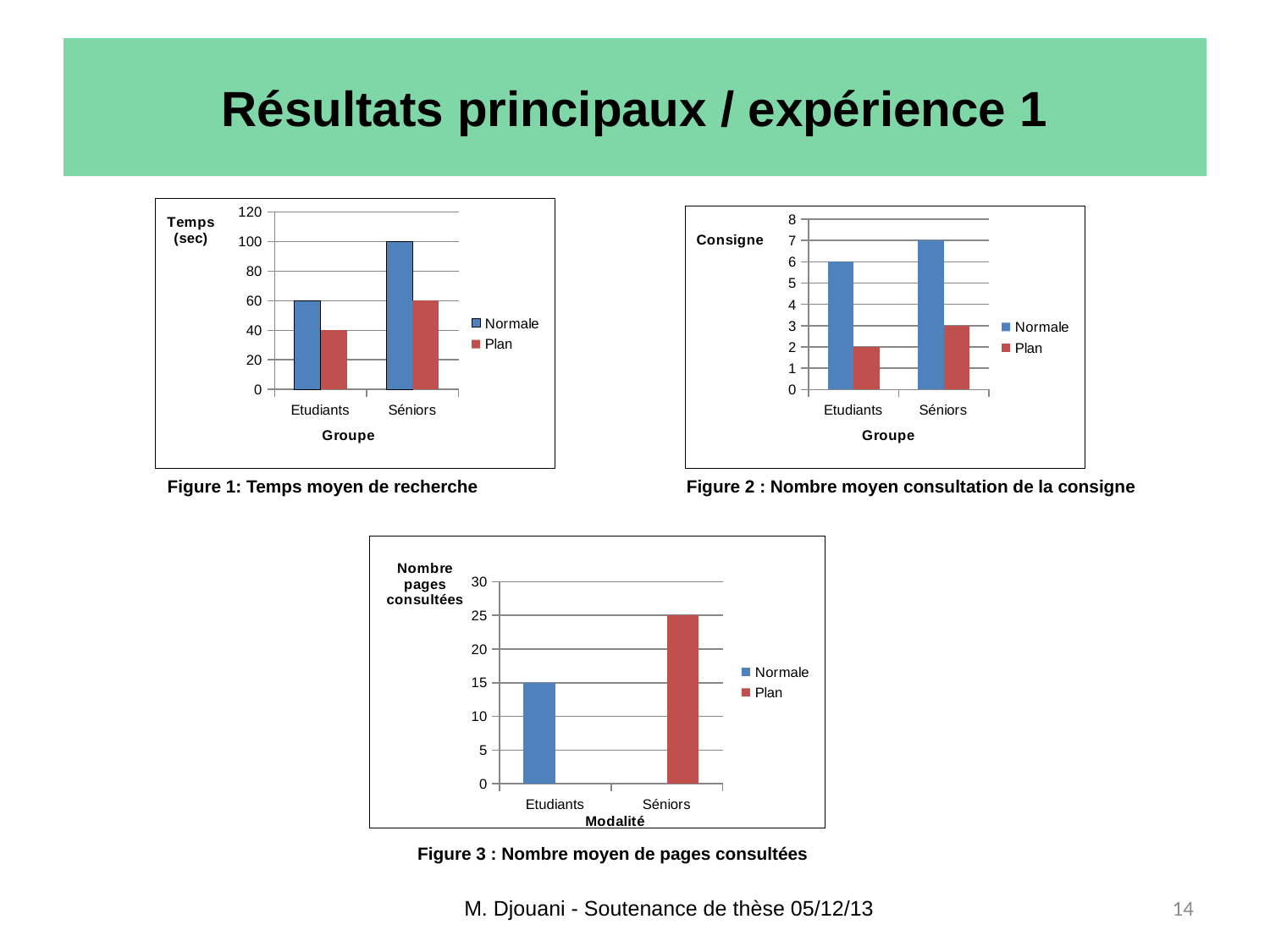
In Figure 1 (Temps moyen de recherche), which group has the higher Normale value? Séniors What kind of chart is Figure 1 (Temps moyen de recherche)? bar chart In Figure 2 (Nombre moyen consultation de la consigne), which bar is the lowest? Etudiants, Plan In Figure 3 (Nombre moyen de pages consultées), is the value for Etudiants greater or less than 20? less In Figure 1 (Temps moyen de recherche), what is the value for Etudiants in the Plan series? 40 In Figure 1 (Temps moyen de recherche), what is the difference between the Normale and Plan values for Séniors? 40 In Figure 3 (Nombre moyen de pages consultées), what is the value for Séniors? 25 In Figure 2 (Nombre moyen consultation de la consigne), what is the difference between the Normale and Plan values for Etudiants? 4 In Figure 2 (Nombre moyen consultation de la consigne), what is the value for Etudiants in the Normale series? 6 How many series does the legend of Figure 3 (Nombre moyen de pages consultées) list? 2 In Figure 1 (Temps moyen de recherche), what is the value for Séniors in the Normale series? 100 In Figure 2 (Nombre moyen consultation de la consigne), what is the value for Séniors in the Plan series? 3